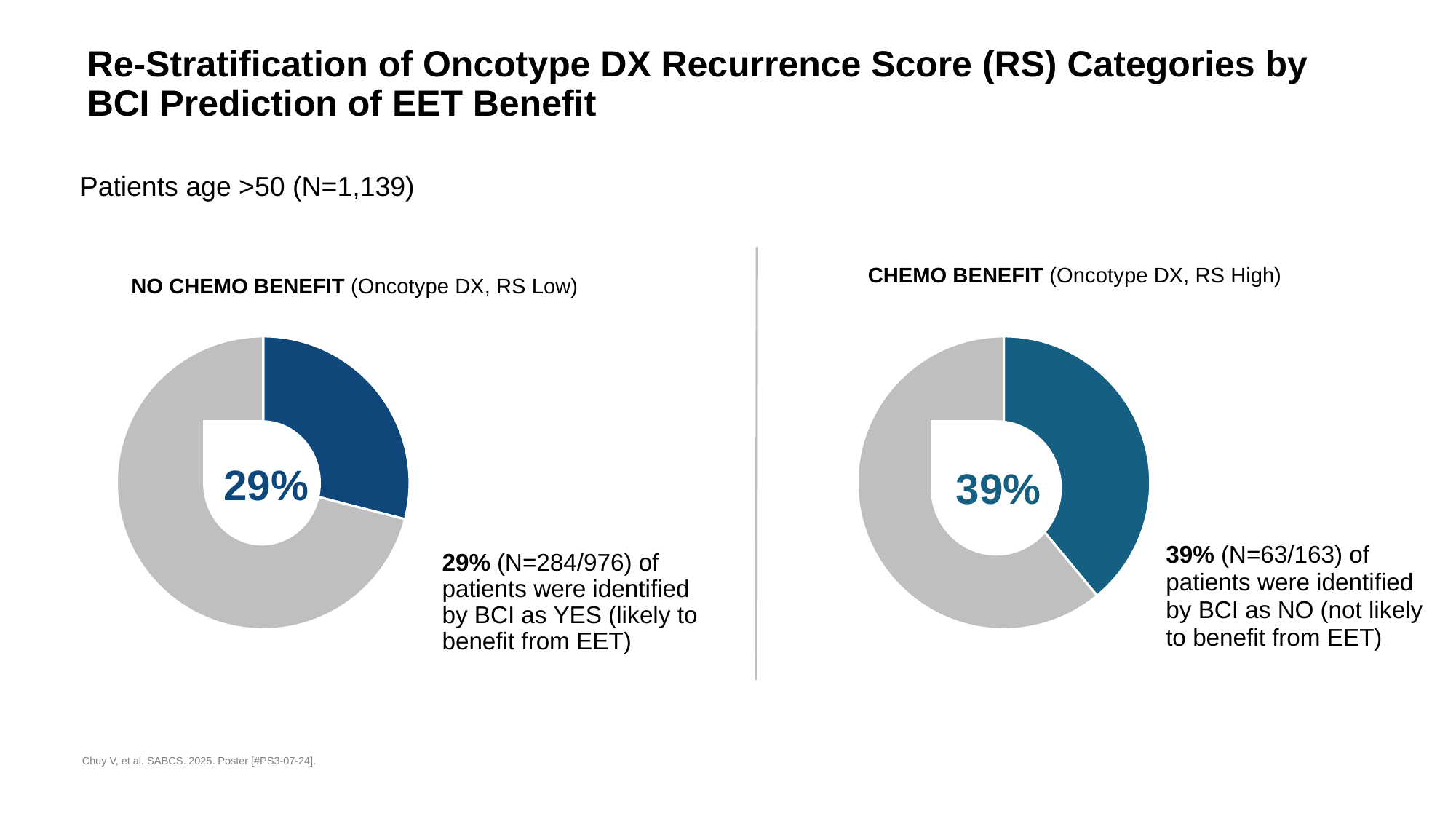
In the CHEMO BENEFIT (Oncotype DX, RS High) chart, what percentage of patients were identified by BCI as NO (not likely to benefit from EET)? 39% In the NO CHEMO BENEFIT (Oncotype DX, RS Low) chart, what percentage of patients were identified by BCI as YES (likely to benefit from EET)? 29% What Oncotype DX RS category is shown in the chart on the right side of the slide? RS High How many patients (N) does the NO CHEMO BENEFIT chart's 29% correspond to? N=284/976 In the CHEMO BENEFIT chart, what share of the donut does the grey slice represent? 61% How many slices does the NO CHEMO BENEFIT donut chart have? 2 In the NO CHEMO BENEFIT chart, what share of the donut does the blue slice represent? 29% What kind of chart is shown under the NO CHEMO BENEFIT heading? Pie chart (donut) How many patients (N) does the CHEMO BENEFIT chart's 39% correspond to? N=63/163 What is the difference in percentage points between the highlighted value in the CHEMO BENEFIT chart (39%) and the NO CHEMO BENEFIT chart (29%)? 10 percentage points What is the total number of patients (N) stated for the slide's population of patients age >50? N=1,139 Which chart shows the larger highlighted percentage, NO CHEMO BENEFIT or CHEMO BENEFIT? CHEMO BENEFIT